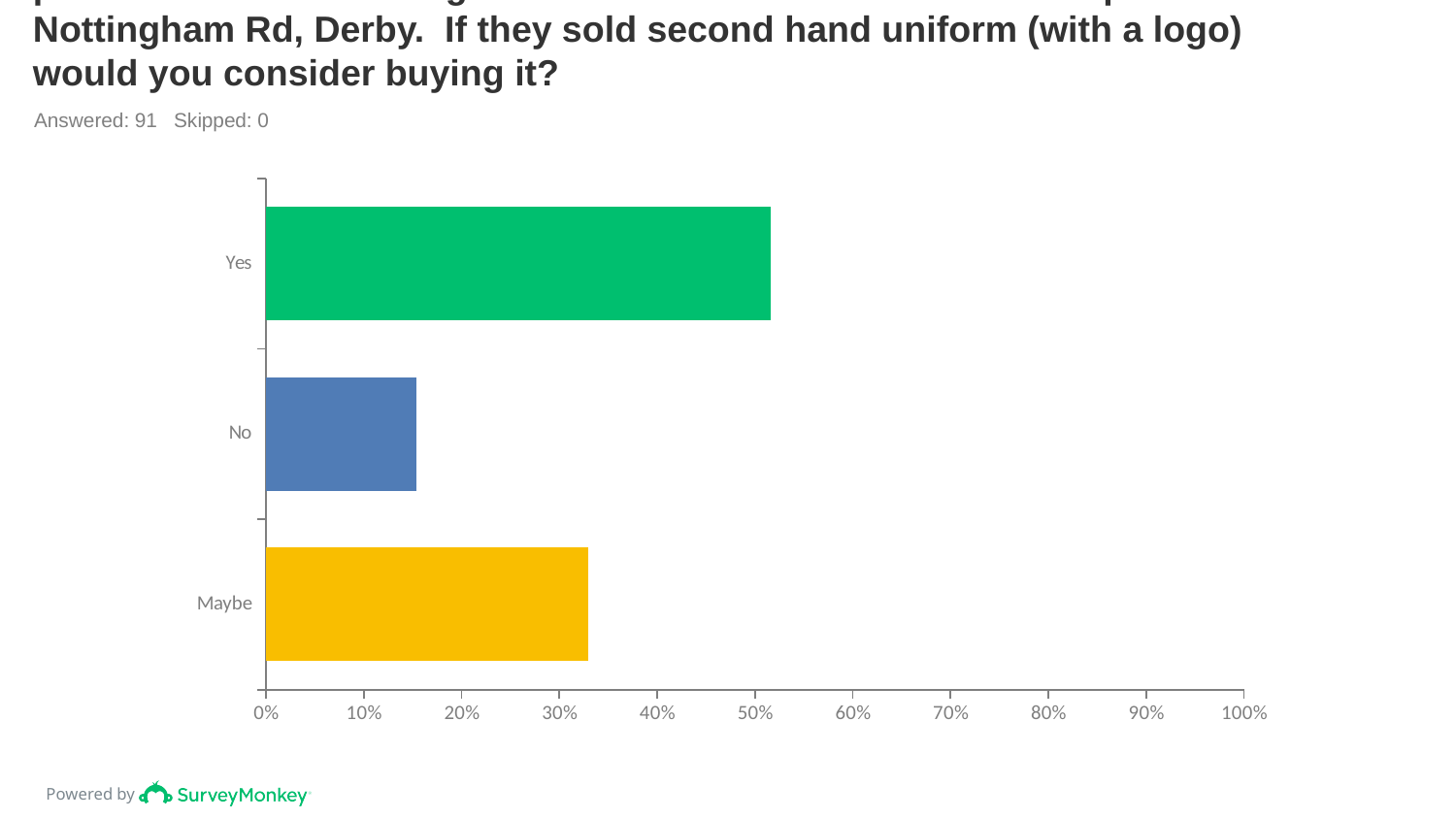
Is the value for No greater or less than 10%? greater What kind of chart is shown on the slide? bar chart What colour is the bar for Yes? green How many categories are plotted in the chart? 3 Which category has the highest value? Yes Which category has the lowest value? No What is the maximum value shown on the horizontal axis? 100% Which is larger, the value for No or the value for Maybe? Maybe Is the value for Yes greater or less than 40%? greater Which is larger, the value for Yes or the value for Maybe? Yes Is the value for No greater or less than 20%? less